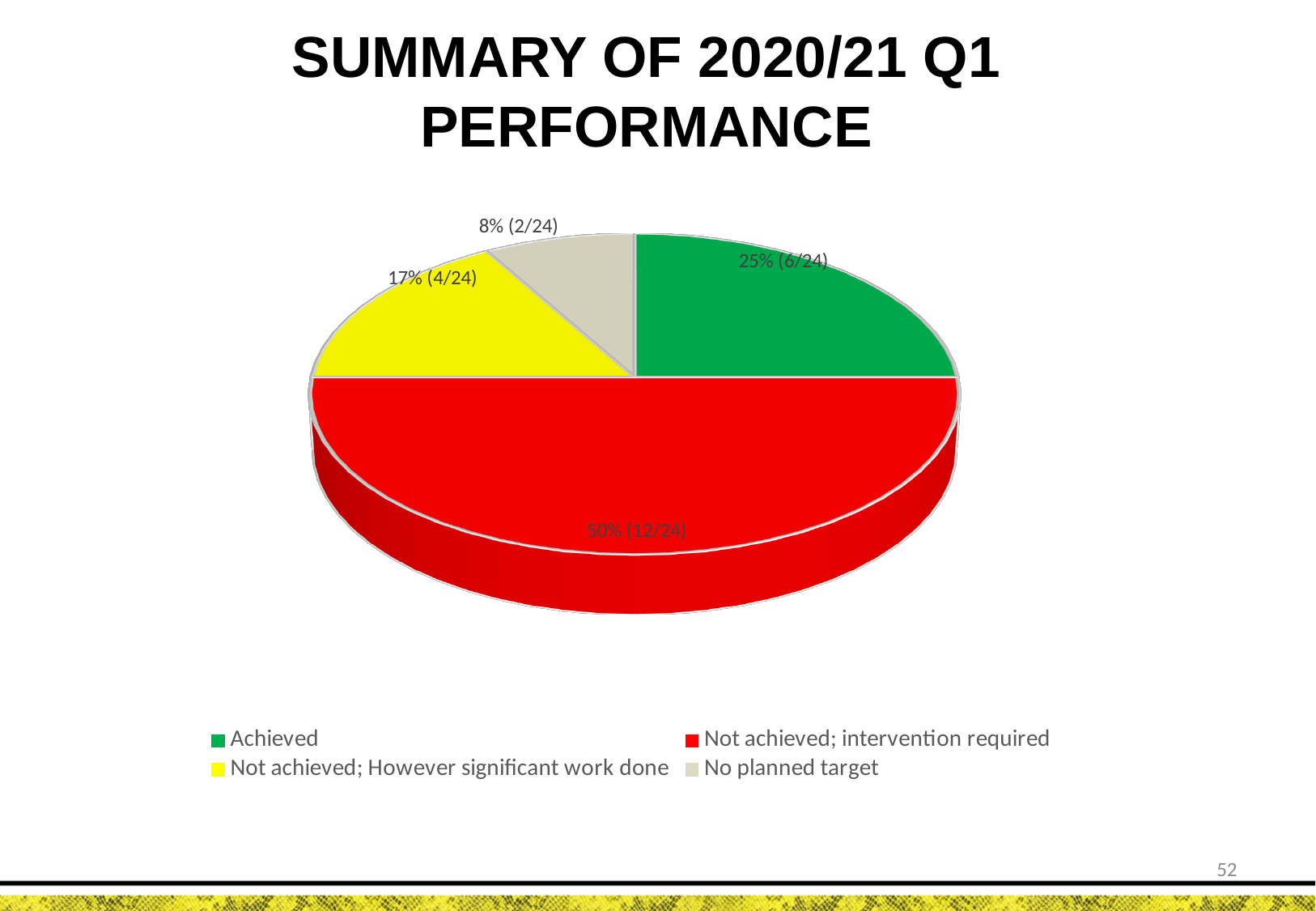
How many categories does the pie chart show? 4 What is the difference in percentage points between the Not achieved; intervention required slice and the Achieved slice? 25 What colour is the slice for Not achieved; However significant work done? Yellow Which is larger, the slice for Achieved or the slice for No planned target? Achieved What share of the pie is labelled for Not achieved; intervention required? 50% (12/24) Which category has the largest slice of the pie? Not achieved; intervention required What share of the pie is labelled for Achieved? 25% (6/24) What share of the pie is labelled for No planned target? 8% (2/24) What share of the pie is labelled for Not achieved; However significant work done? 17% (4/24) How many entries does the legend list? 4 What kind of chart is shown on the slide? Pie chart Which category has the smallest slice of the pie? No planned target